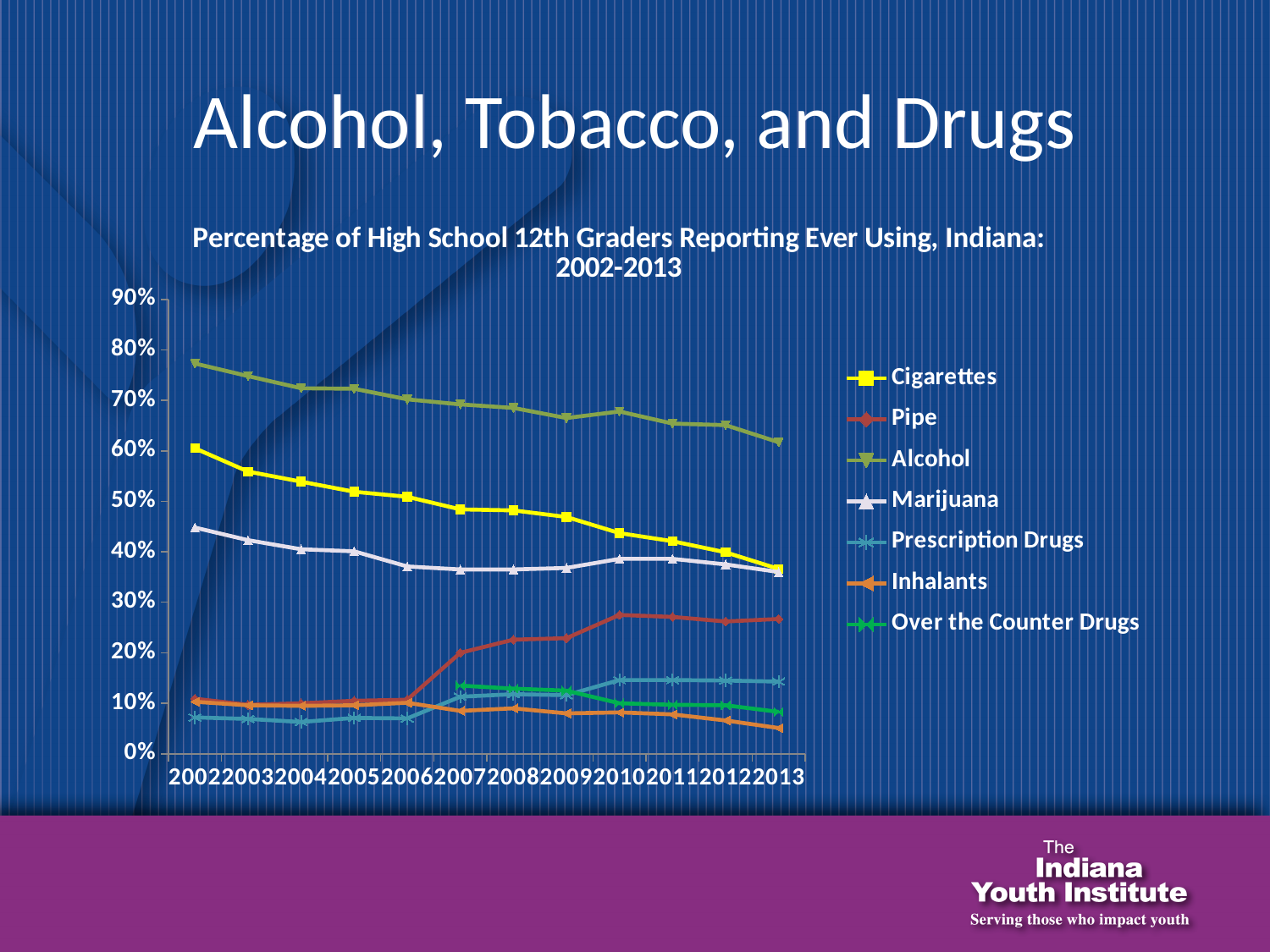
What is the title of the chart? Percentage of High School 12th Graders Reporting Ever Using, Indiana: 2002-2013 Do the values for Pipe rise or fall from 2002 to 2013? Rise Is the value for Cigarettes in 2013 greater or less than 40%? less In 2002, which is larger: the value for Cigarettes or the value for Marijuana? Cigarettes Which series has the highest values across all years? Alcohol Is the value for Alcohol in 2002 greater or less than 70%? greater How many years are plotted along the x axis? 12 Is the value for Pipe in 2010 greater or less than 20%? greater Do the values for Cigarettes rise or fall from 2002 to 2013? Fall How many series does the legend list? 7 What kind of chart is shown on the slide? Line chart Which series has the lowest value in 2013? Inhalants